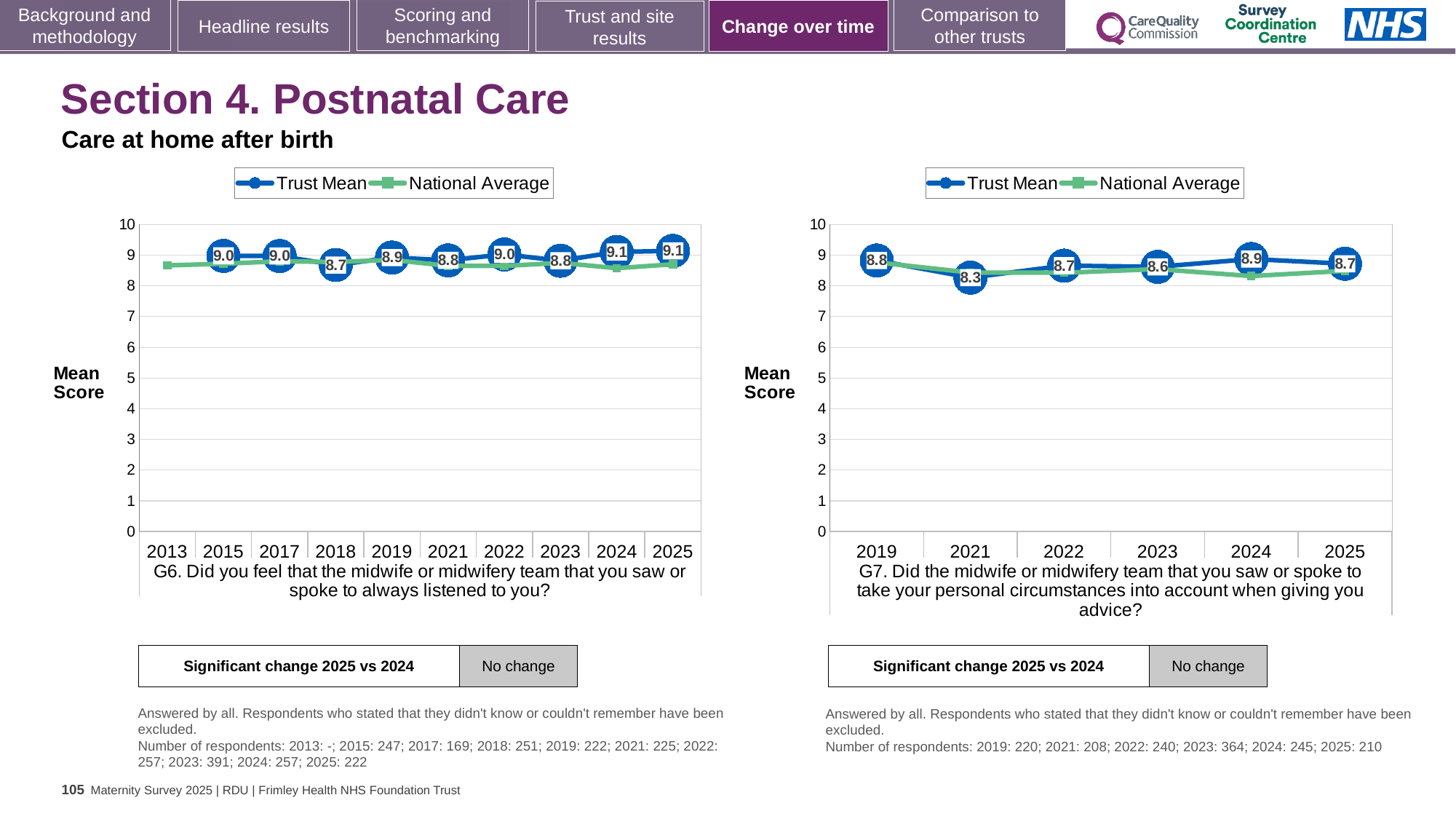
On the right chart (G7), what is the difference between the Trust Mean scores for 2024 and 2021? 0.6 On the right chart (G7), what is the Trust Mean score for 2024? 8.9 On the right chart (G7), what is the Trust Mean score for 2021? 8.3 On the left chart (G6), is the National Average value for 2013 greater or less than 9? less On the left chart (G6), which year has the lowest Trust Mean score? 2018 On the right chart (G7), which year has the lowest Trust Mean score? 2021 How many series does the legend of the left chart (G6) list? 2 What type of chart is used on the left (G6)? Line chart On the left chart (G6), is the Trust Mean score for 2024 larger or smaller than the Trust Mean score for 2023? larger On the left chart (G6), what is the Trust Mean score for 2025? 9.1 On the left chart (G6), what is the Trust Mean score for 2018? 8.7 How many years are shown on the x axis of the right chart (G7)? 6